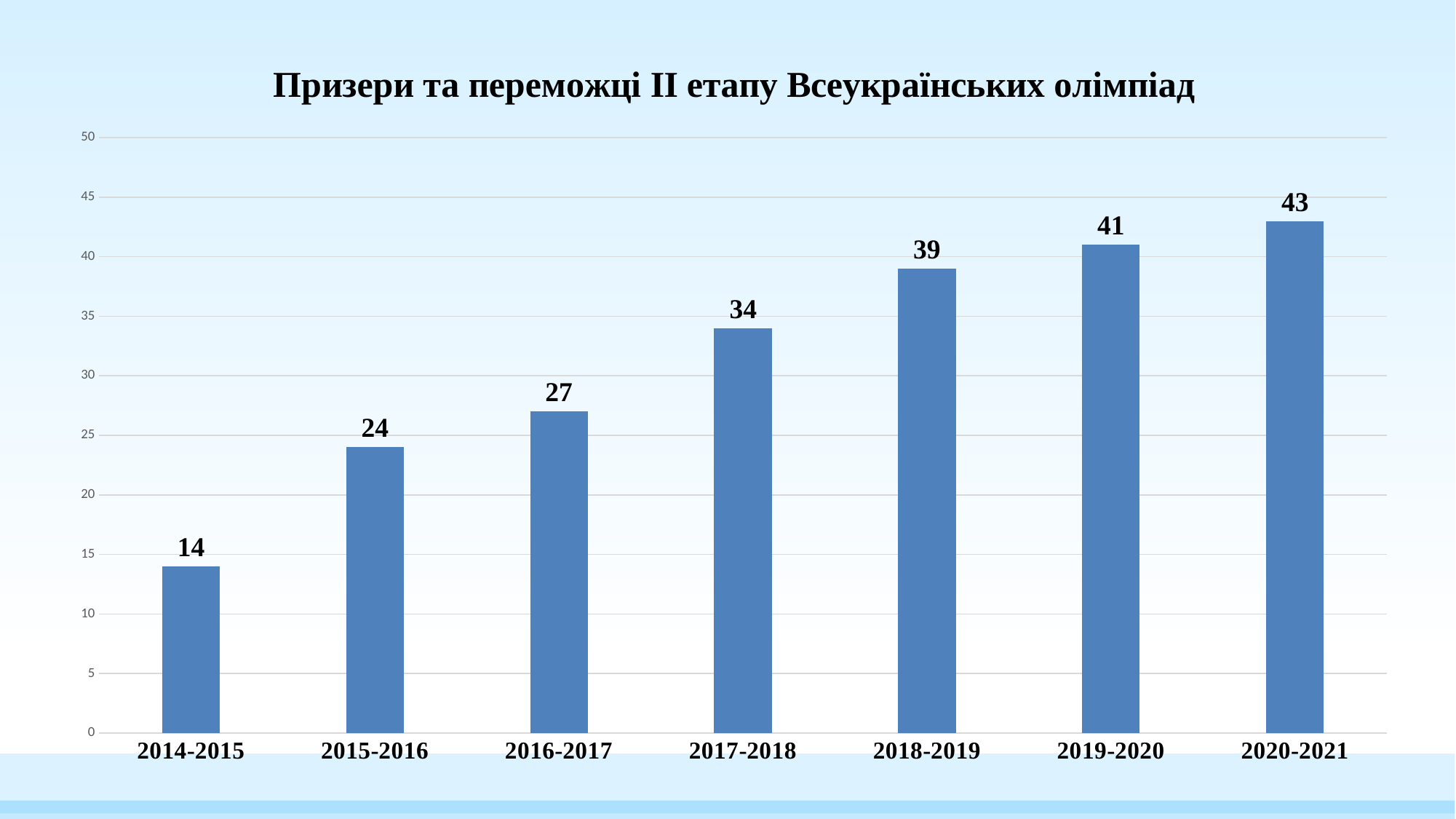
Which year has the highest value? 2020-2021 What is the value for 2019-2020? 41 What kind of chart is this? bar chart Do the values rise or fall from 2014-2015 to 2020-2021? rise What is the value for 2014-2015? 14 What is the difference between the values for 2020-2021 and 2014-2015? 29 Which year has the lowest value? 2014-2015 What is the value for 2017-2018? 34 How many years are shown on the x axis? 7 Is the value for 2016-2017 greater or less than 25? greater Which is larger, the value for 2018-2019 or the value for 2017-2018? 2018-2019 What is the difference between the values for 2016-2017 and 2015-2016? 3